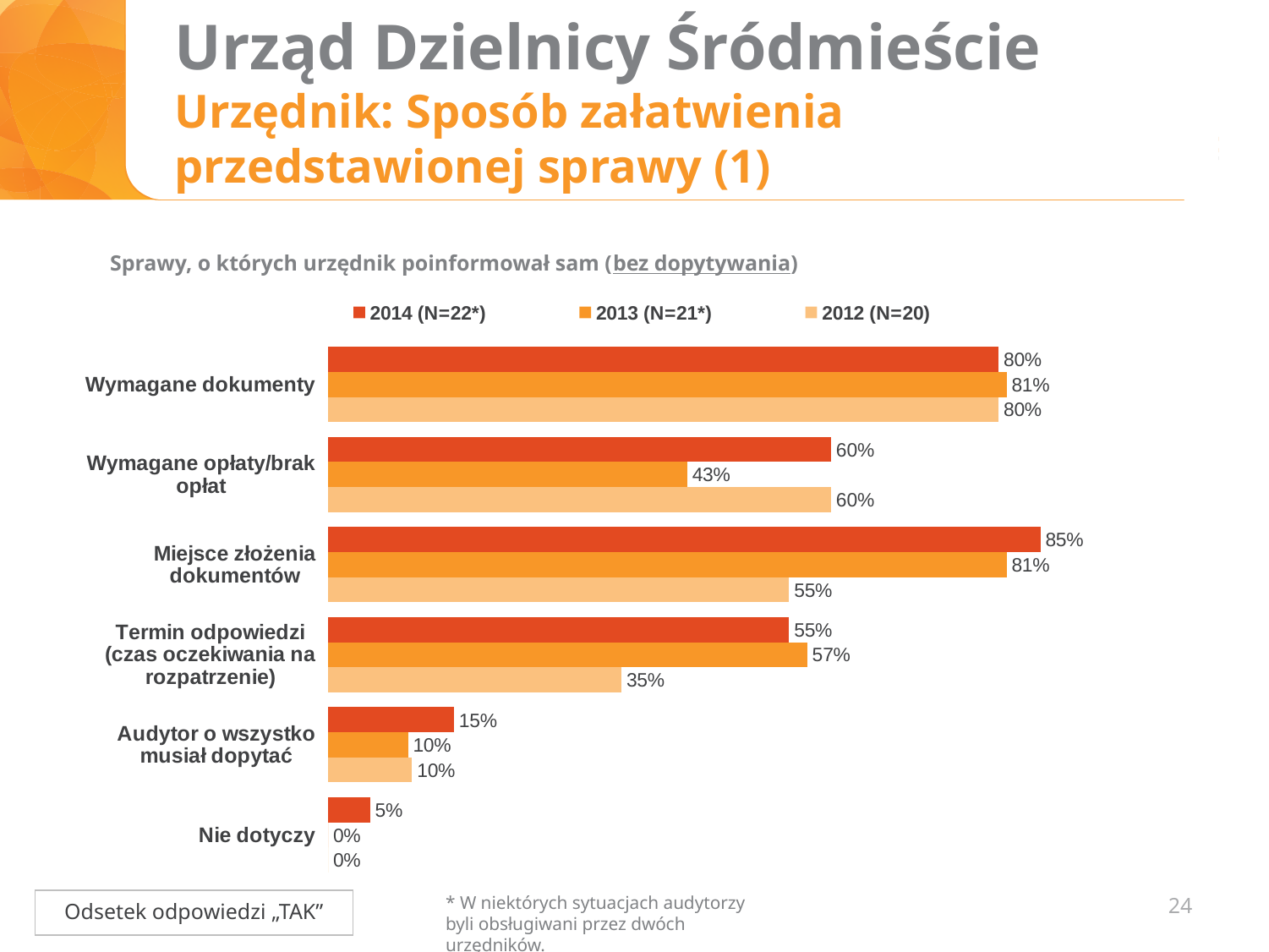
What is the value for "Wymagane dokumenty" in the 2013 (N=21*) series? 81% How many categories are shown on the chart? 6 What is the value for "Termin odpowiedzi (czas oczekiwania na rozpatrzenie)" in the 2014 (N=22*) series? 55% What kind of chart is shown on the slide? Bar chart How many series does the legend list? 3 What is the difference between the 2014 and 2012 values for "Miejsce złożenia dokumentów"? 30% Which category has the lowest value in the 2014 (N=22*) series? Nie dotyczy Which is larger for "Termin odpowiedzi (czas oczekiwania na rozpatrzenie)": the 2013 value or the 2012 value? 2013 What is the value for "Miejsce złożenia dokumentów" in the 2012 (N=20) series? 55% What is the value for "Wymagane opłaty/brak opłat" in the 2013 (N=21*) series? 43% What is the value for "Audytor o wszystko musiał dopytać" in the 2014 (N=22*) series? 15% Which category has the highest value in the 2014 (N=22*) series? Miejsce złożenia dokumentów